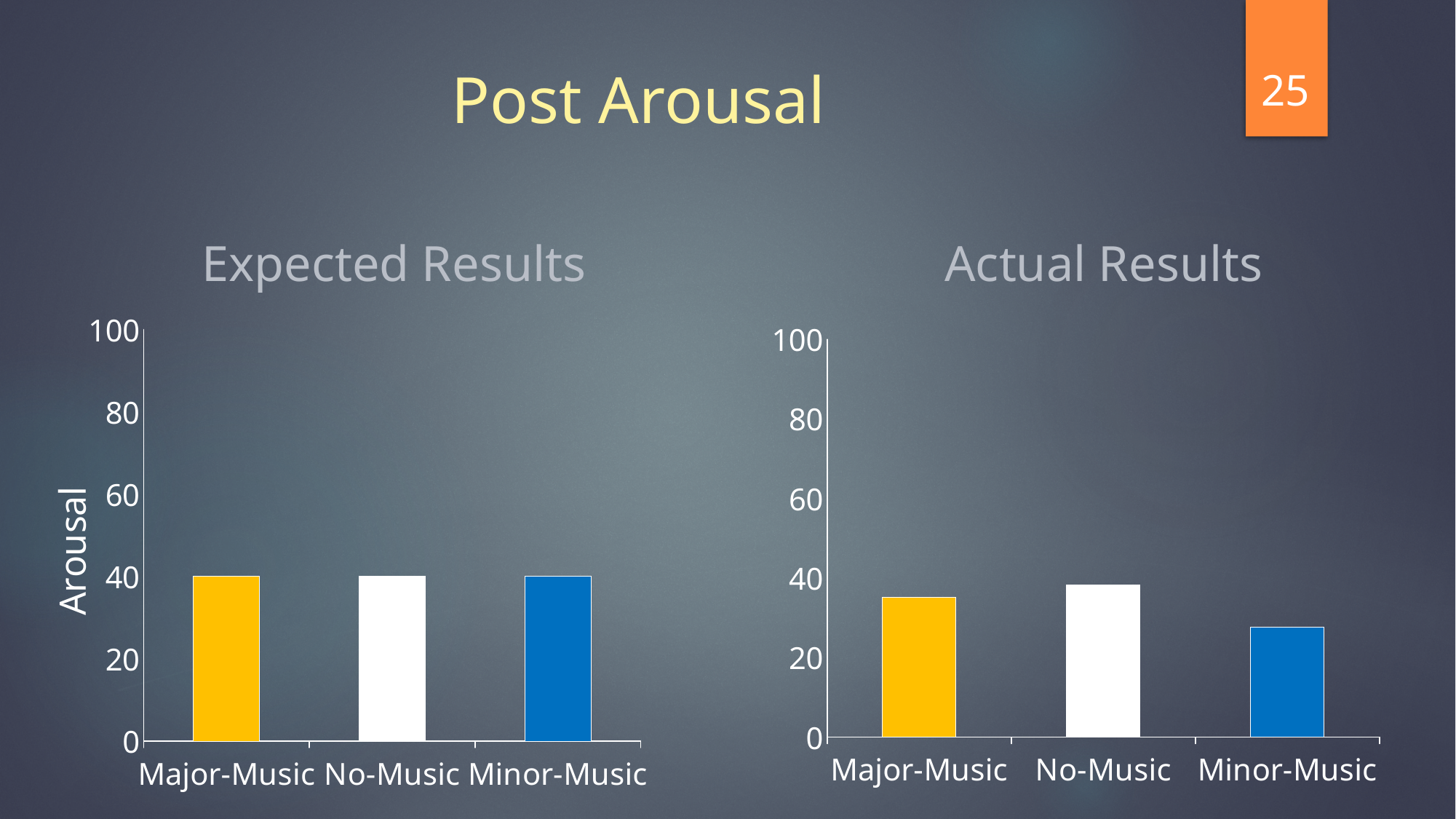
What colour is the Minor-Music bar in the Actual Results chart? blue In the Actual Results chart, which category has the highest value? No-Music In the Actual Results chart, is the value for Major-Music greater or less than 40? less How many categories are shown on the Actual Results chart? 3 In the Expected Results chart, what is the value for No-Music? 40 In the Actual Results chart, is the value for Minor-Music greater or less than 20? greater In the Actual Results chart, which is larger, No-Music or Minor-Music? No-Music What kind of chart is the Expected Results chart? bar chart In the Expected Results chart, what is the value for Major-Music? 40 In the Actual Results chart, is the value for Minor-Music greater or less than 40? less In the Actual Results chart, which category has the lowest value? Minor-Music What is the y-axis label on the Expected Results chart? Arousal